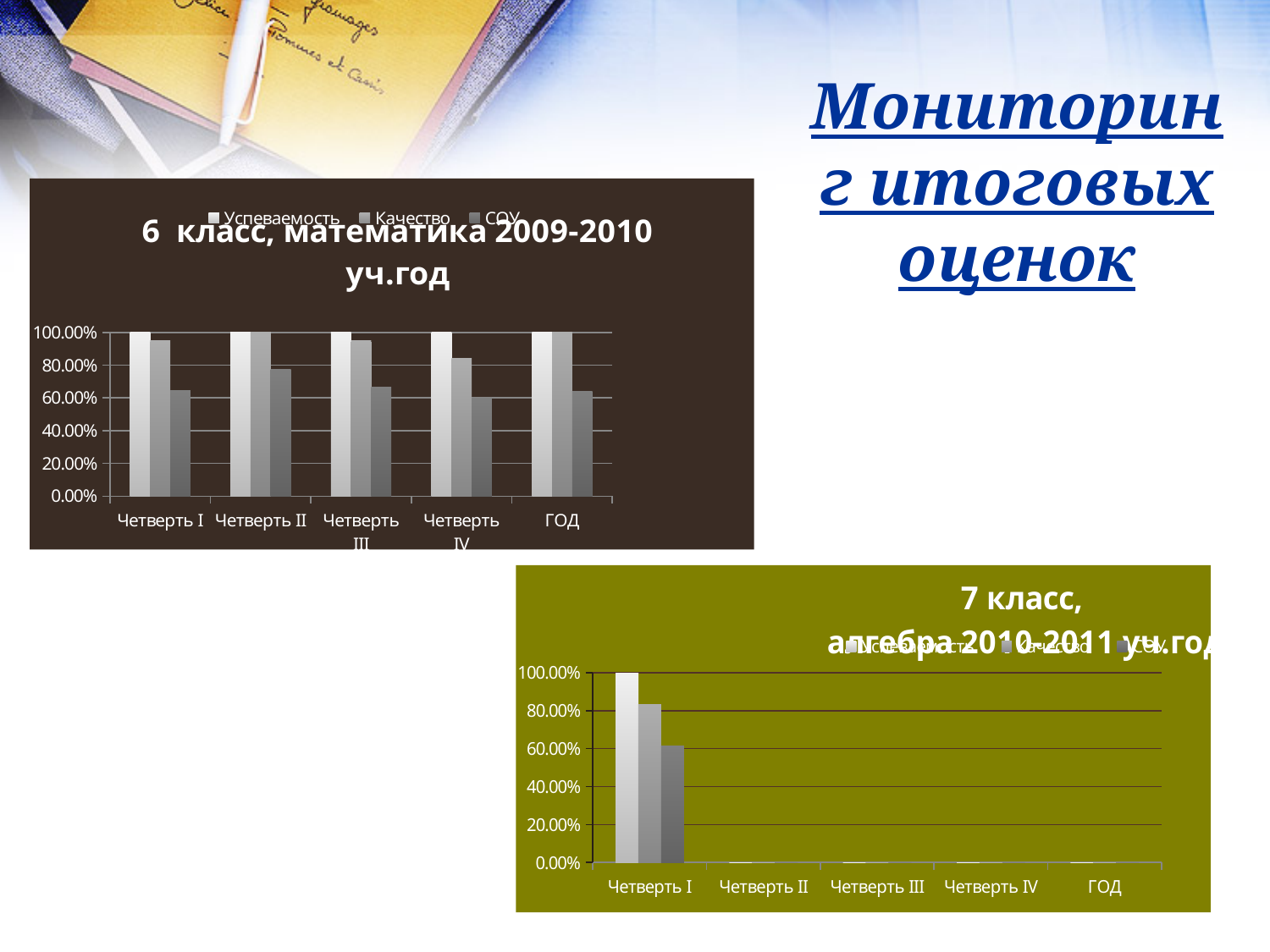
What is the title of the chart on the dark brown background? 6 класс, математика 2009-2010 уч.год In the '6 класс, математика 2009-2010 уч.год' chart, is the value of СОУ for Четверть II greater or less than 60.00%? greater In the '6 класс, математика 2009-2010 уч.год' chart, is the value of Качество for Четверть IV greater or less than 80.00%? greater What kind of chart is the '6 класс, математика 2009-2010 уч.год' chart? bar chart How many series does the legend of the '6 класс, математика 2009-2010 уч.год' chart list? 3 In the '6 класс, математика 2009-2010 уч.год' chart, which category has the highest СОУ value? Четверть II In the '7 класс, алгебра 2010-2011 уч.год' chart, is the value of СОУ for Четверть I greater or less than 80.00%? less How many categories are shown on the x axis of the '6 класс, математика 2009-2010 уч.год' chart? 5 In the '6 класс, математика 2009-2010 уч.год' chart, which category has the lowest Качество value? Четверть IV How many categories are shown on the x axis of the '7 класс, алгебра 2010-2011 уч.год' chart? 5 What kind of chart is the '7 класс, алгебра 2010-2011 уч.год' chart? bar chart In the '6 класс, математика 2009-2010 уч.год' chart, which is larger for Четверть III: Качество or СОУ? Качество